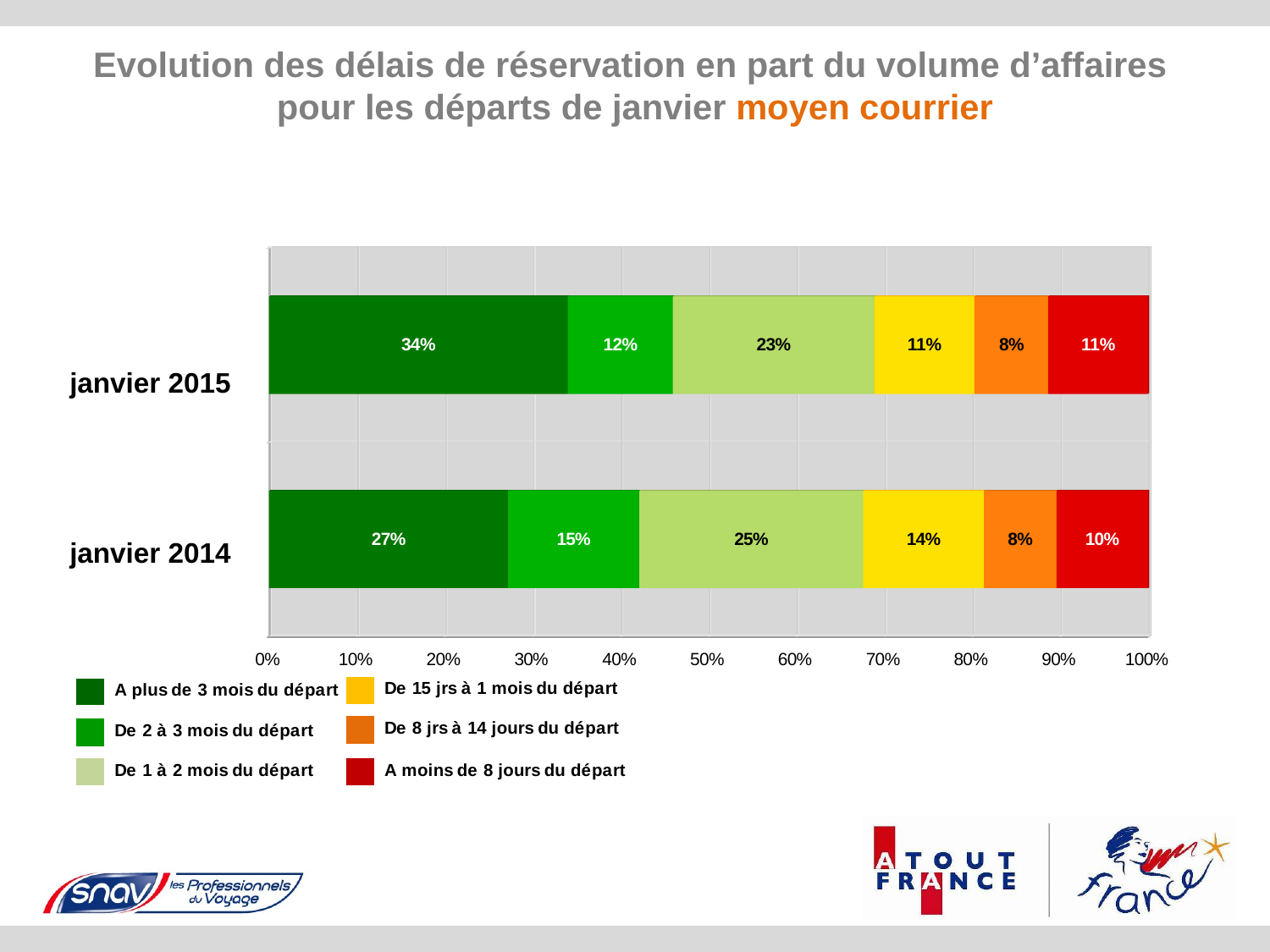
What colour represents 'A moins de 8 jours du départ' in the legend? Red What kind of chart is shown on the slide? Stacked bar chart What is the value for 'De 1 à 2 mois du départ' in janvier 2014? 25% Which segment is the largest in the janvier 2014 bar? A plus de 3 mois du départ What is the value for 'De 15 jrs à 1 mois du départ' in janvier 2014? 14% What is the difference between the 'A plus de 3 mois du départ' values for janvier 2015 and janvier 2014? 7% How many bars (categories) are shown in the chart? 2 What is the value for 'A plus de 3 mois du départ' in janvier 2015? 34% Which segment is the smallest in the janvier 2015 bar? De 8 jrs à 14 jours du départ Which year has the larger value for 'De 2 à 3 mois du départ', janvier 2015 or janvier 2014? janvier 2014 How many series does the legend list? 6 What is the value for 'A moins de 8 jours du départ' in janvier 2015? 11%